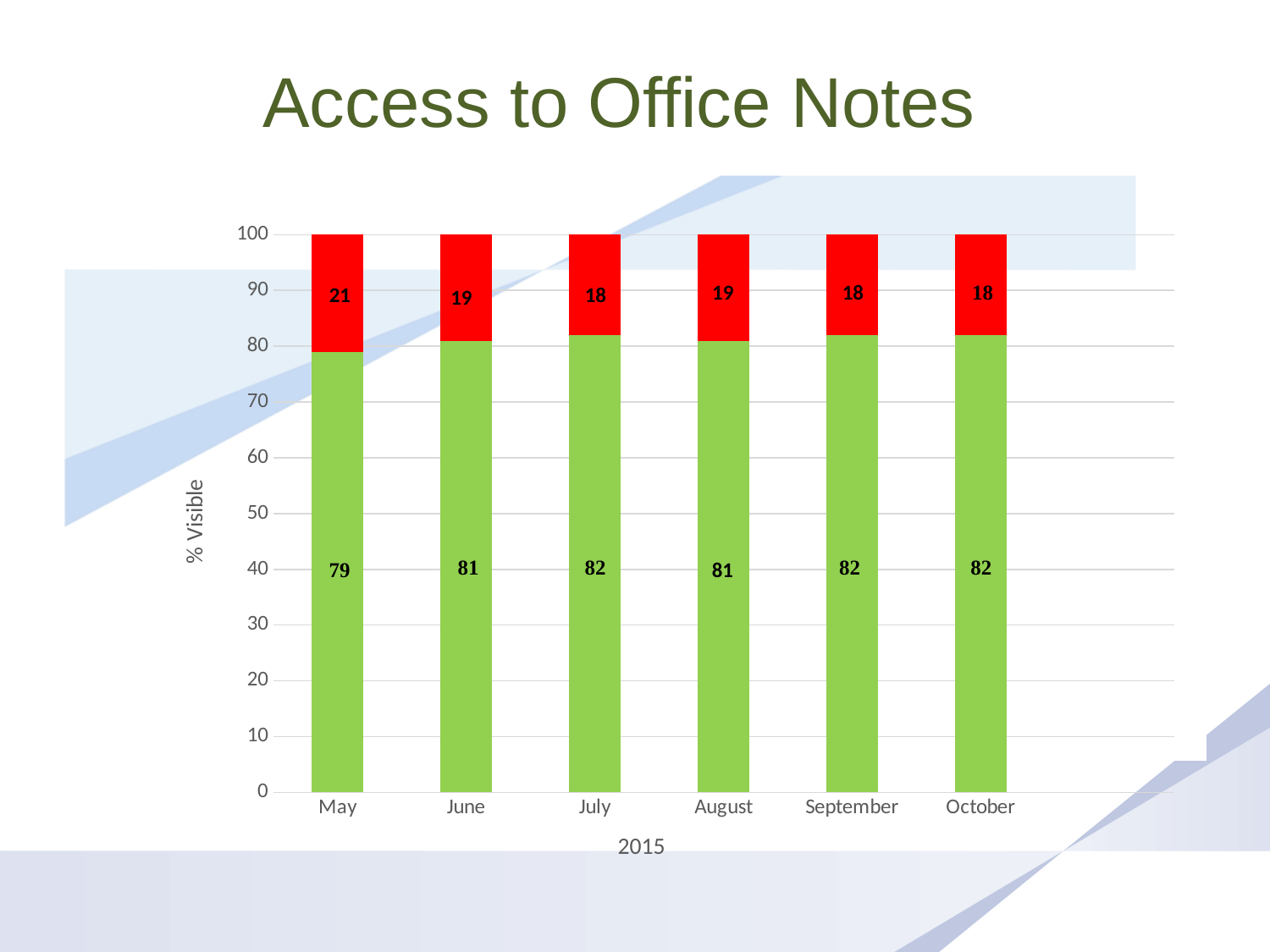
Which month has the lowest green segment value? May What is the difference between the green segment values for July and May? 3 Which is larger, the green segment for June or the green segment for July? July How many months are shown on the x axis? 6 What is the value of the red segment for October? 18 What is the value of the green segment for August? 81 Which month has the highest red segment value? May What is the label on the vertical axis? % Visible What kind of chart is shown on the slide? Stacked bar chart What is the value of the green segment for May? 79 Do the green segment values rise or fall from May to October overall? Rise What is the total of the stacked bar for May? 100